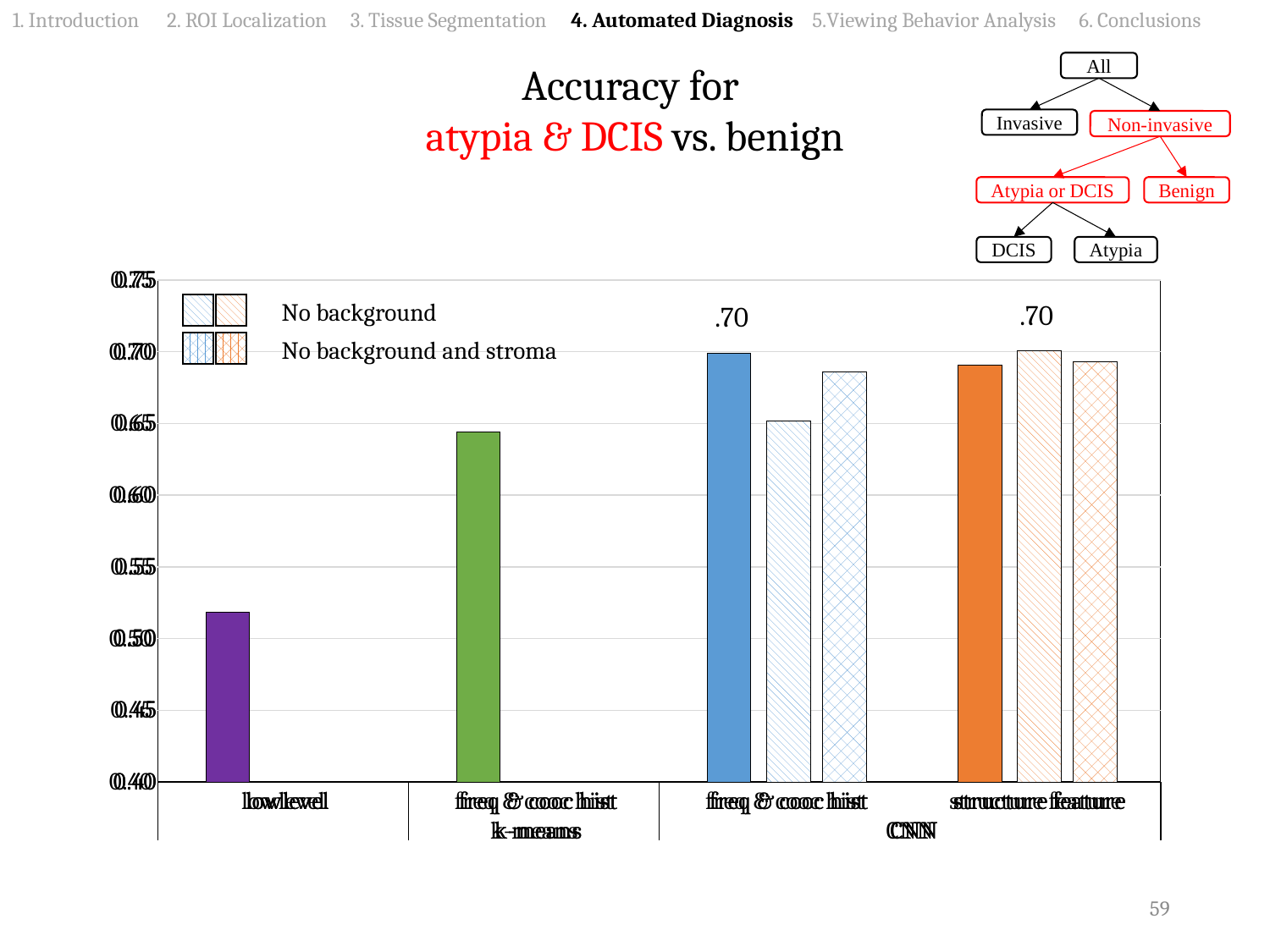
What value is printed as a data label above the structure feature (CNN) group? .70 Which category has the lowest accuracy in the chart? lowlevel What are the two entries in the chart legend? No background; No background and stroma What value is printed as a data label above the freq & cooc hist (CNN) group? .70 How many entries does the chart legend list? 2 What kind of chart is shown on the slide? bar chart How many categories are labeled along the x axis of the chart? 4 What is the title of the chart? Accuracy for atypia & DCIS vs. benign Is the accuracy for low level greater or less than 0.55? less Which has the higher accuracy: low level or freq & cooc hist (k-means)? freq & cooc hist (k-means) Is the accuracy for freq & cooc hist (k-means) greater or less than 0.60? greater Do the accuracy values generally rise or fall moving from left to right along the x axis? rise